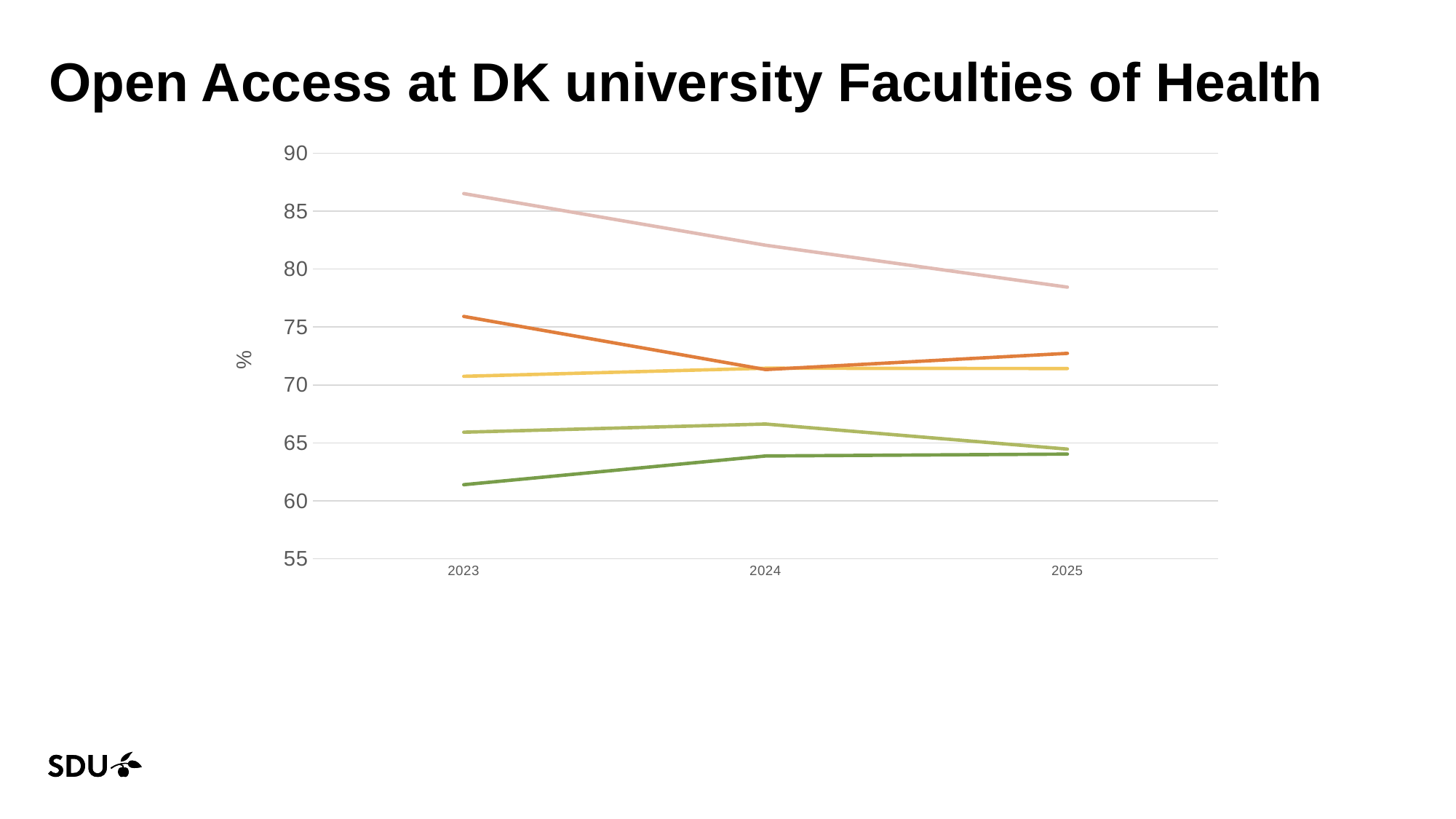
Is the value of the light pink line in 2023 greater or less than 85? greater In 2023, which is higher: the light pink line or the orange line? the light pink line Does the dark green line rise or fall from 2023 to 2024? rise Is the value of the dark green line in 2023 greater or less than 65? less Is the value of the light pink line in 2025 greater or less than 80? less How many years are shown on the x axis of the chart? 3 What kind of chart is shown on the slide? line chart What is the label on the y axis of the chart? % What is the title of the chart on the slide? Open Access at DK university Faculties of Health In which year does the light pink line reach its highest value? 2023 Does the light pink line rise or fall from 2023 to 2025? fall